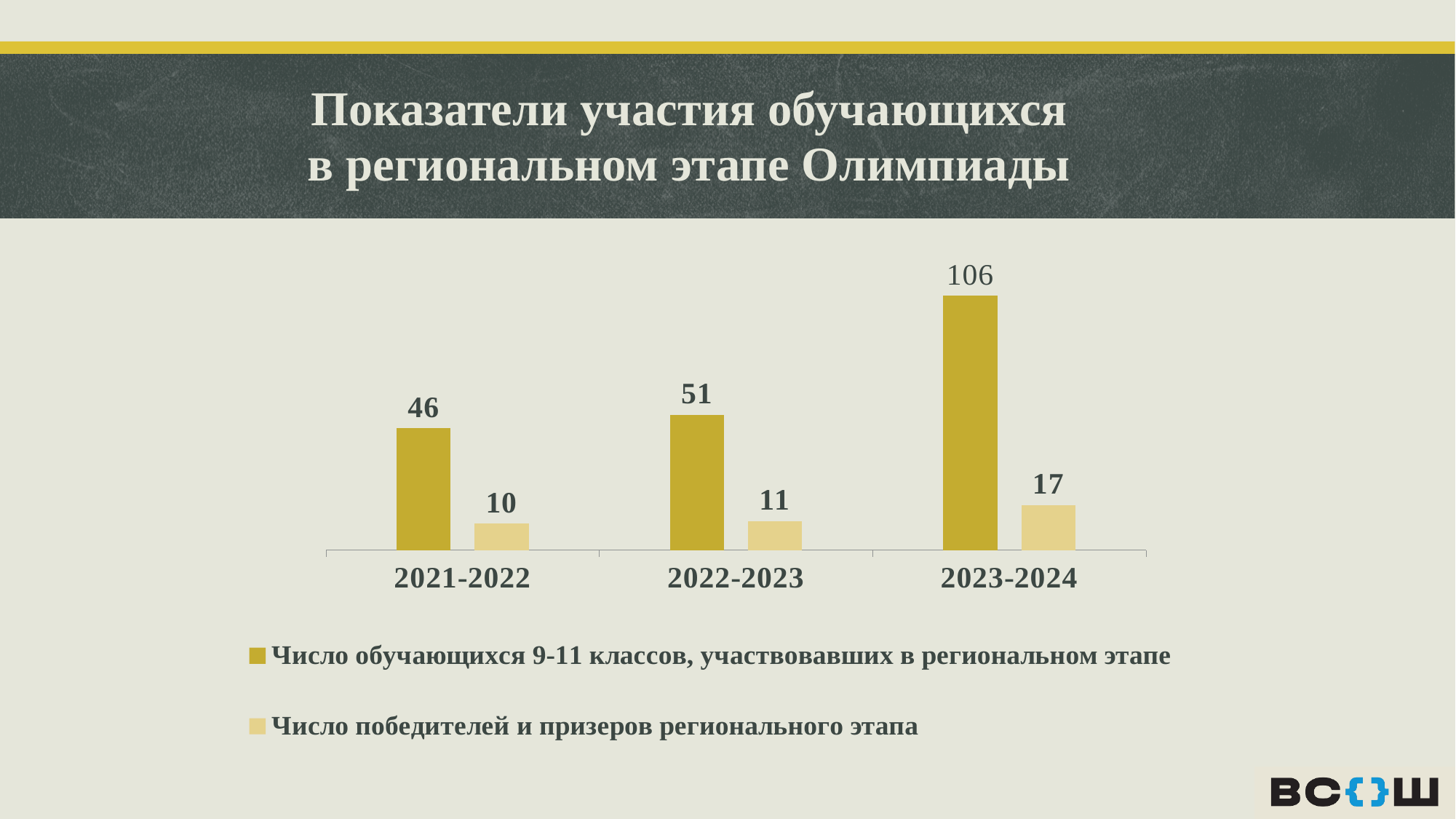
Which academic year has the lowest number of winners and prize-winners of the regional stage? 2021-2022 What is the difference between the number of participants and the number of winners and prize-winners in 2021-2022? 36 By how much did the number of participants in the regional stage increase from 2022-2023 to 2023-2024? 55 Which is larger: the number of winners and prize-winners in 2022-2023 or in 2023-2024? 2023-2024 How many academic years are shown on the x axis of the chart? 3 Does the number of participants in the regional stage rise or fall from 2021-2022 to 2023-2024? Rise What is the number of students in grades 9-11 who participated in the regional stage in 2023-2024? 106 What is the number of students in grades 9-11 who participated in the regional stage in 2022-2023? 51 What kind of chart is shown on the slide? Bar chart What is the number of winners and prize-winners of the regional stage in 2021-2022? 10 Which academic year has the highest number of participants in the regional stage? 2023-2024 How many series does the legend list? 2